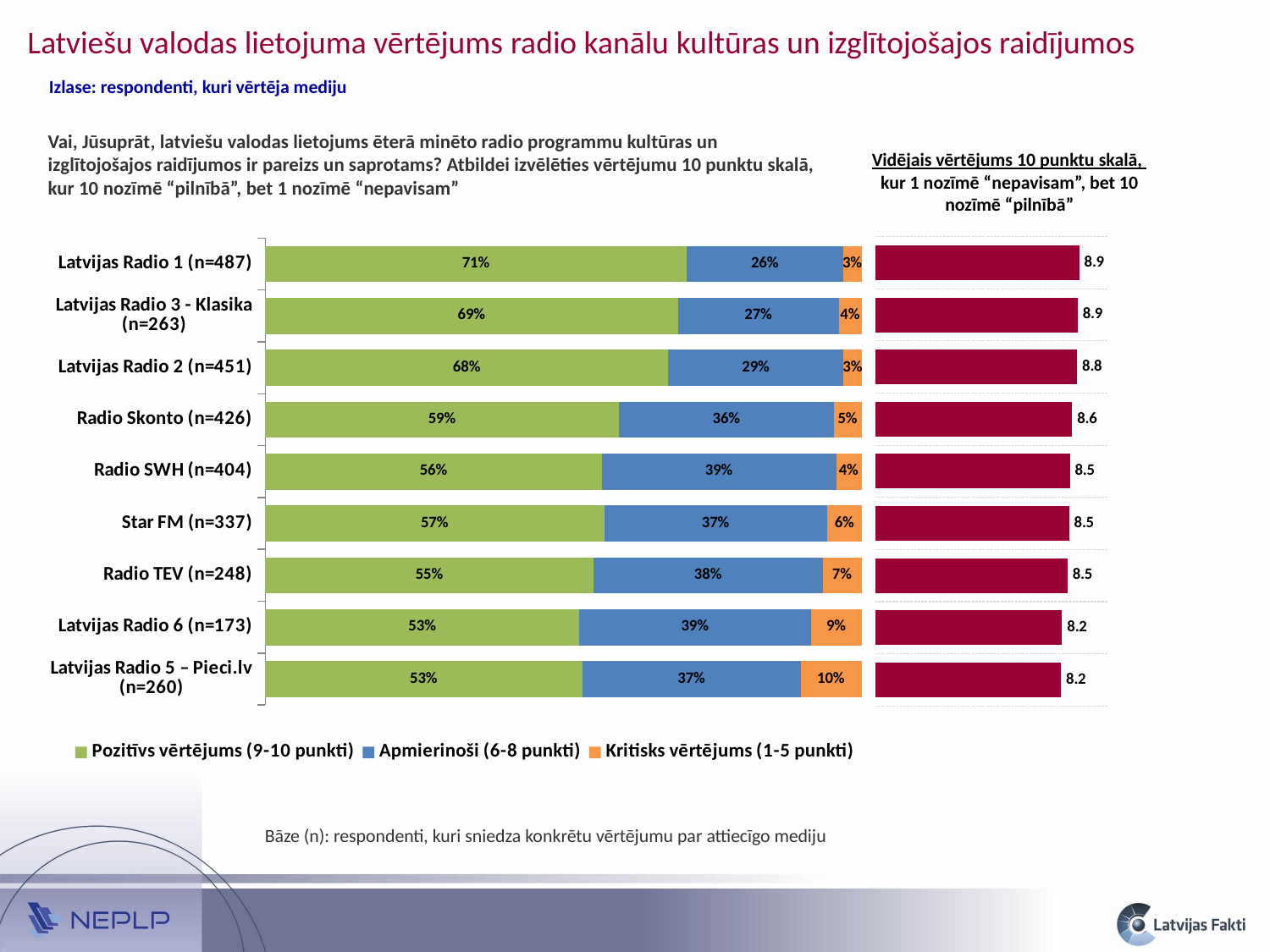
How many radio stations are listed in the stacked bar chart on the left? 9 In the stacked bar chart on the left, which station has the highest share of positive ratings (9-10 punkti)? Latvijas Radio 1 (n=487) In the stacked bar chart on the left, what is the total of the three segments for Radio SWH (n=404)? 99% In the stacked bar chart on the left, what is the critical rating (1-5 punkti) share for Latvijas Radio 5 – Pieci.lv (n=260)? 10% How many series does the legend of the stacked bar chart on the left list? 3 In the stacked bar chart on the left, what percentage of respondents gave a positive rating (9-10 punkti) for Latvijas Radio 1 (n=487)? 71% In the stacked bar chart on the left, what is the difference between the positive rating share for Latvijas Radio 1 (n=487) and Radio TEV (n=248)? 16 percentage points In the stacked bar chart on the left, which colour represents Kritisks vērtējums (1-5 punkti)? Orange In the right-hand chart of average ratings (Vidējais vērtējums 10 punktu skalā), what is the average rating for Radio Skonto (n=426)? 8.6 What kind of chart is the chart on the left of the slide? Stacked bar chart In the stacked bar chart on the left, which station has the highest share of critical ratings (1-5 punkti)? Latvijas Radio 5 – Pieci.lv (n=260) In the right-hand chart of average ratings, which is higher: the average for Latvijas Radio 2 (n=451) or for Latvijas Radio 6 (n=173)? Latvijas Radio 2 (n=451)